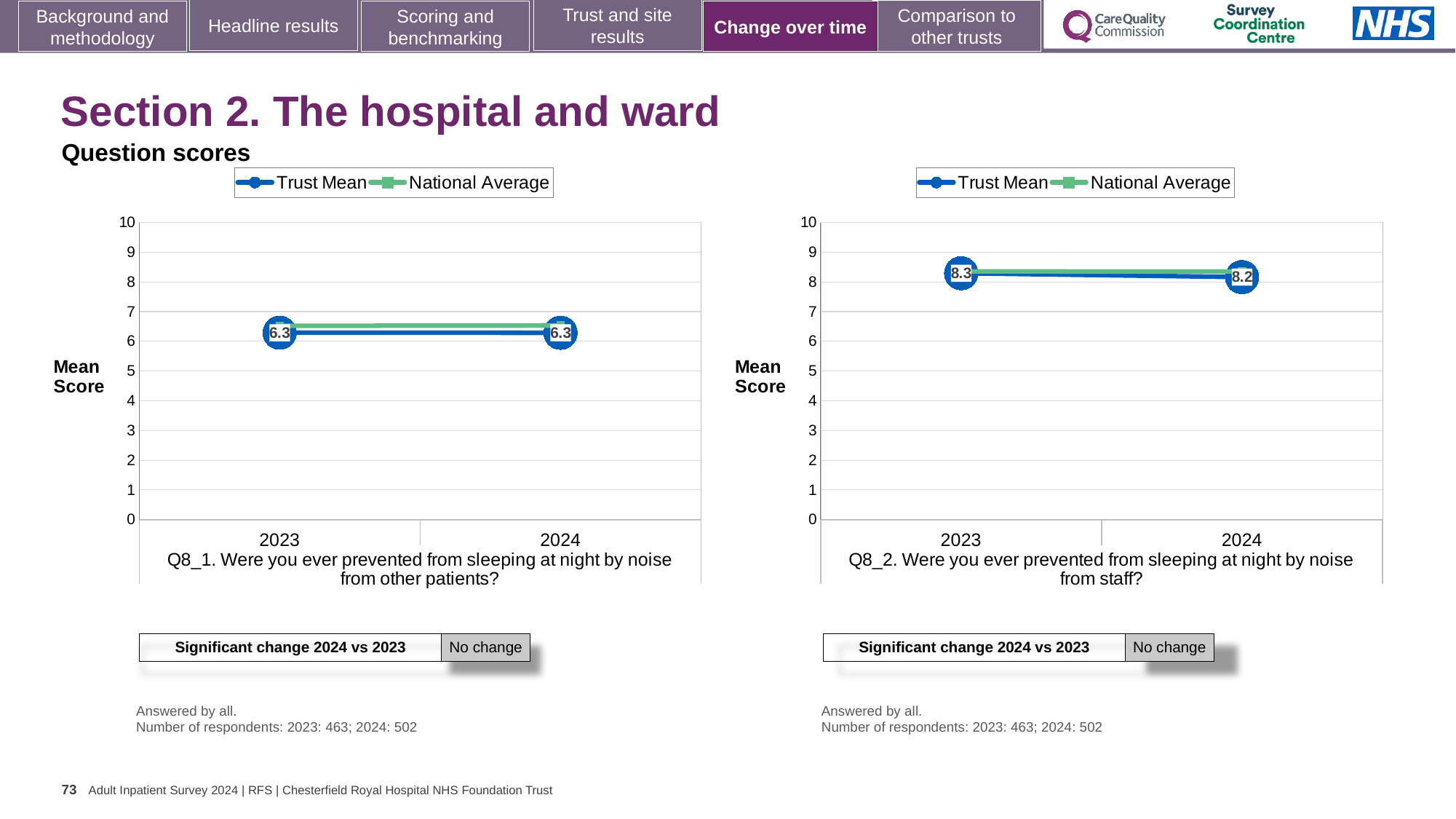
In the Q8_1 chart (left), does the Trust Mean rise, fall or stay the same from 2023 to 2024? stay the same Which is larger: the 2023 Trust Mean in the Q8_1 chart (left) or the 2023 Trust Mean in the Q8_2 chart (right)? Q8_2 chart (right) In the Q8_2 chart (right), what is the difference between the Trust Mean scores for 2023 and 2024? 0.1 In the Q8_2 chart (right), what is the Trust Mean score for 2024? 8.2 In the Q8_1 chart (left), what is the Trust Mean score for 2024? 6.3 How many series does the legend of the Q8_1 chart (left) list? 2 In the Q8_1 chart (left), what is the Trust Mean score for 2023? 6.3 In the Q8_1 chart (left), is the National Average for 2024 greater or less than 6? greater What kind of chart is the Q8_2 chart (right)? line chart In the Q8_2 chart (right), does the Trust Mean rise, fall or stay the same from 2023 to 2024? fall In the Q8_2 chart (right), is the National Average for 2023 greater or less than 8? greater In the Q8_2 chart (right), what is the Trust Mean score for 2023? 8.3